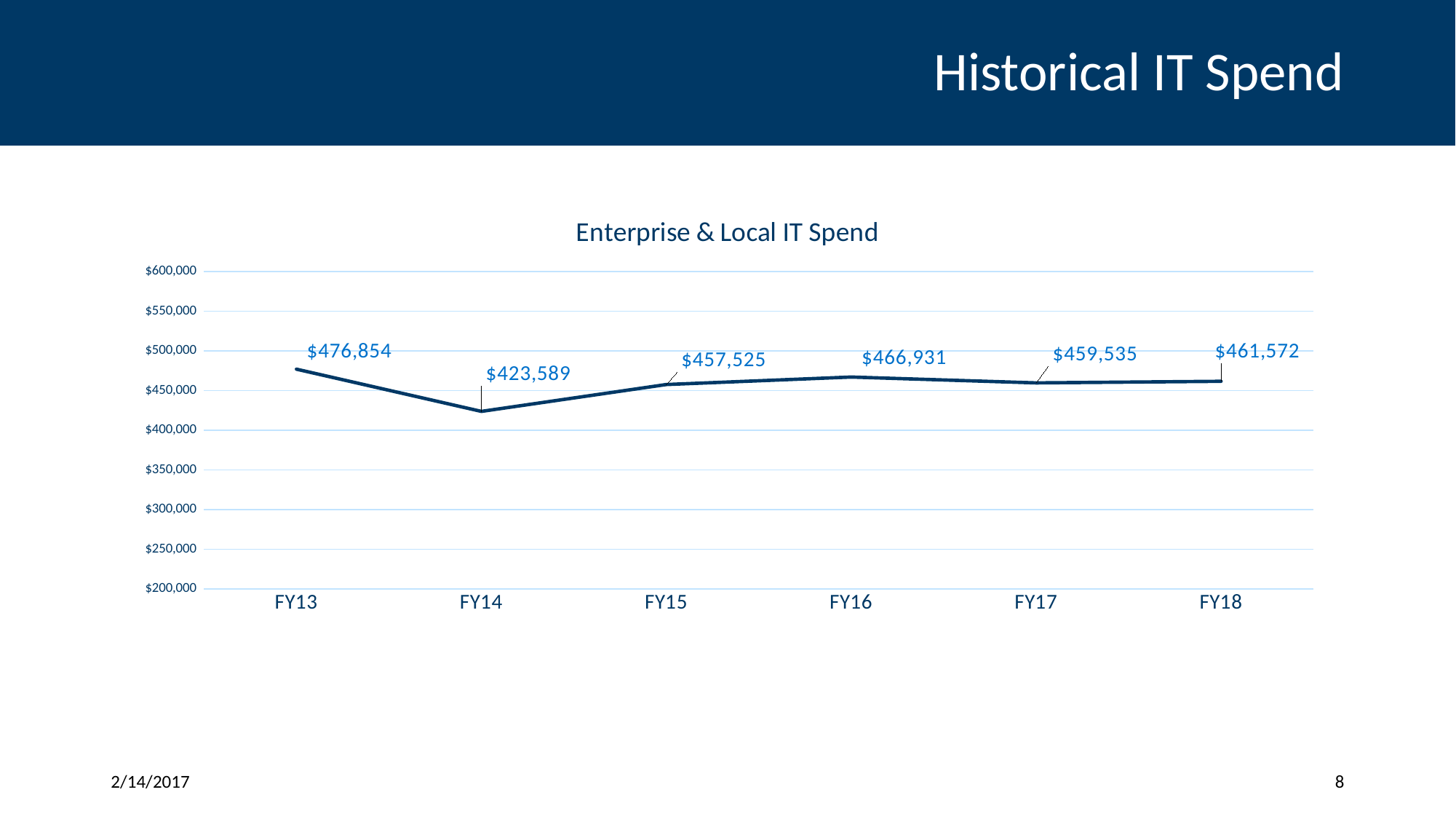
What is the IT spend value for FY13? $476,854 Which fiscal year has the highest IT spend? FY13 What is the difference between the FY13 and FY14 IT spend values? $53,265 Which fiscal year has the lowest IT spend? FY14 What kind of chart is shown on the slide? line chart What is the title of the chart? Enterprise & Local IT Spend What is the IT spend value for FY18? $461,572 Is the IT spend value for FY14 greater or less than $450,000? less What is the difference between the FY16 and FY15 IT spend values? $9,406 How many fiscal years are plotted on the chart? 6 Which is larger, the IT spend for FY15 or for FY16? FY16 What is the IT spend value for FY16? $466,931